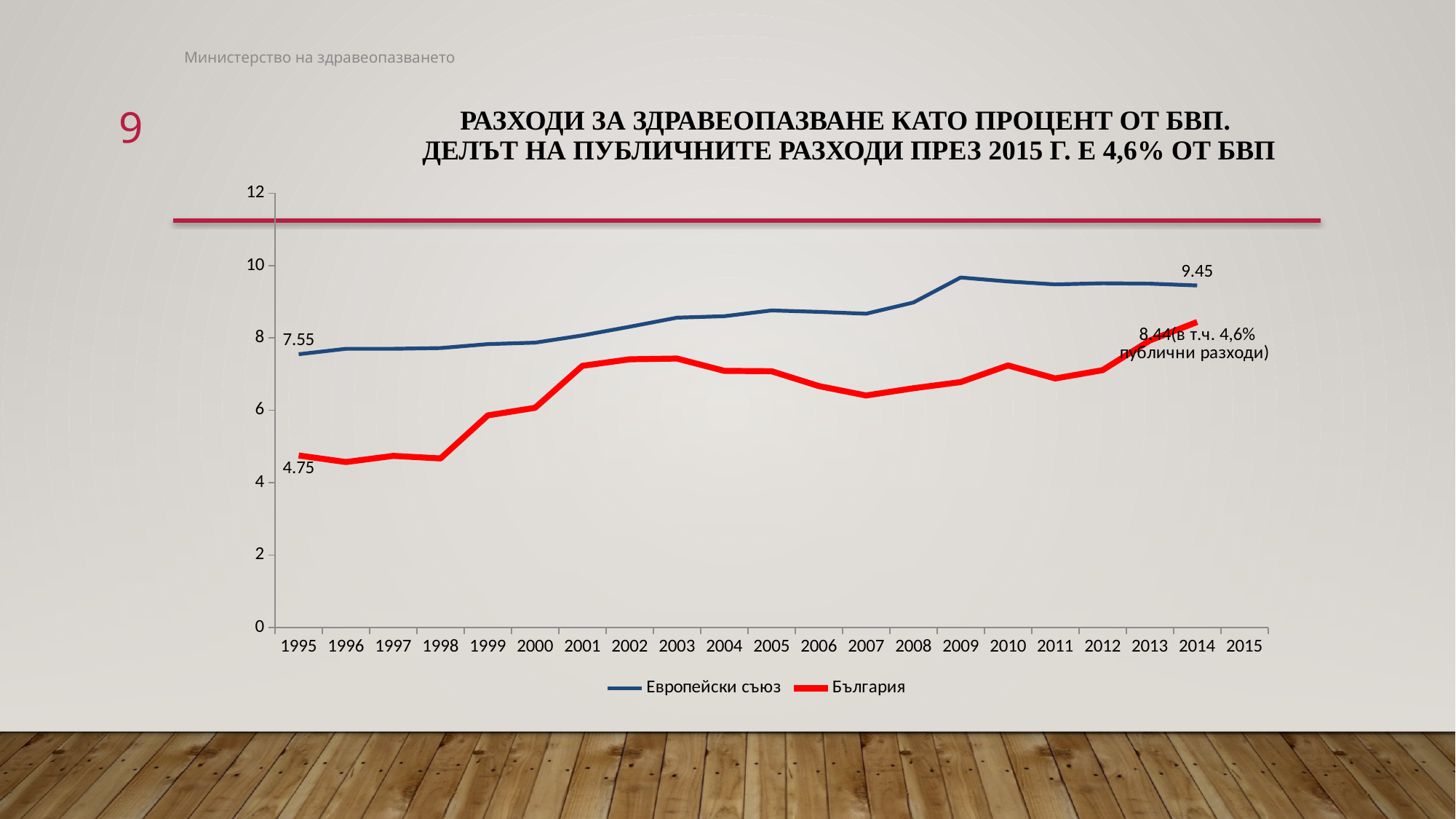
What kind of chart is shown on the slide? line chart What is the value for Европейски съюз in 1995? 7.55 What is the value for България in 2014? 8.44 What is the difference between Европейски съюз and България in 1995? 2.80 Which colour is used for the България line? red By how much did the value for Европейски съюз increase from 1995 to 2014? 1.90 Is the value for България in 2007 greater or less than 8? less By how much did the value for България increase from 1995 to 2014? 3.69 What is the value for България in 1995? 4.75 How many series does the legend list? 2 What is the value for Европейски съюз in 2014? 9.45 Which series has the higher value in 1995, Европейски съюз or България? Европейски съюз